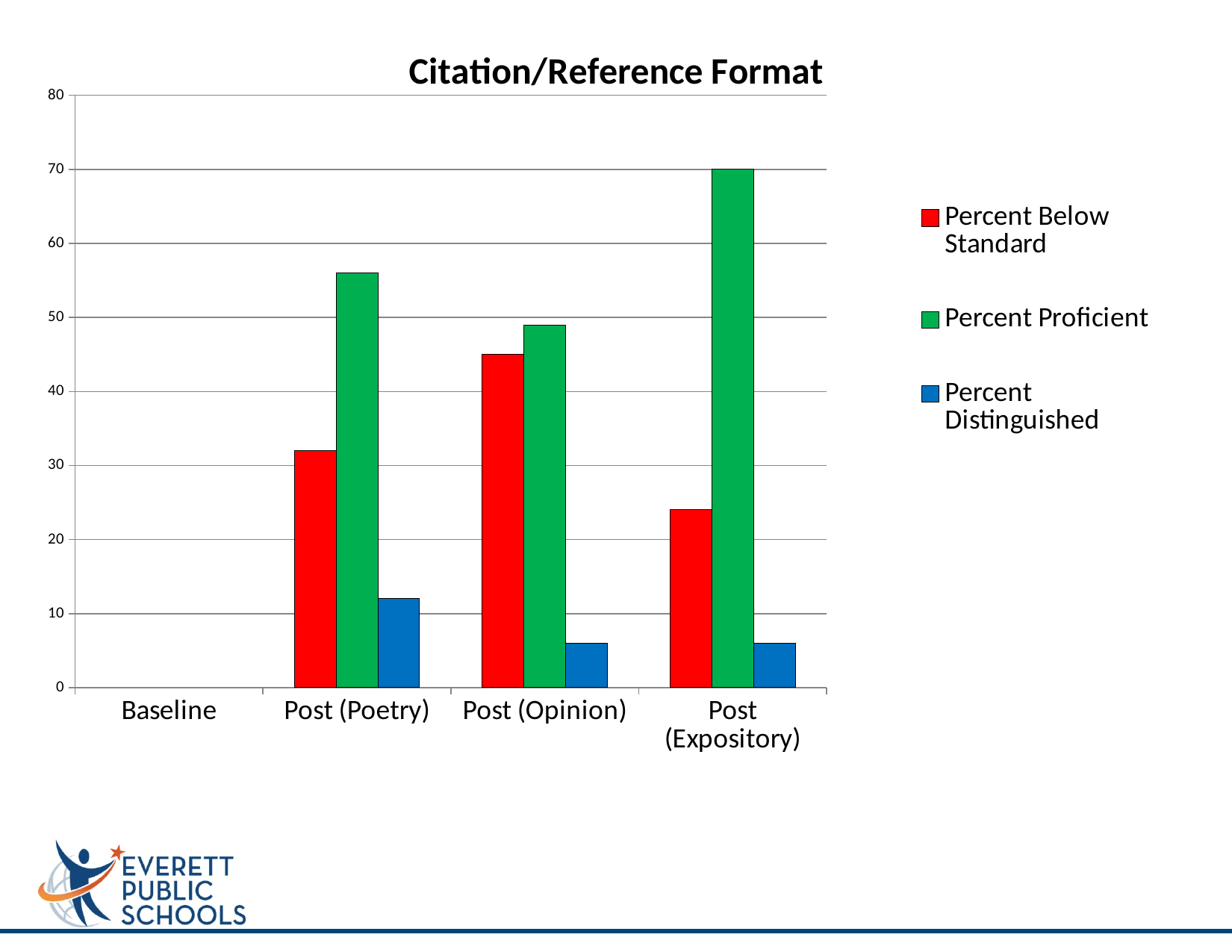
What kind of chart is shown on the slide? bar chart Is the Percent Distinguished value for Post (Opinion) greater or less than 10? less What is the title of the chart? Citation/Reference Format How many series does the legend list? 3 Which category has the highest Percent Distinguished value? Post (Poetry) Is the Percent Below Standard value for Post (Poetry) greater or less than 30? greater What is the Percent Proficient value for Post (Expository)? 70 Which category has the highest Percent Below Standard value? Post (Opinion) For Post (Poetry), which is larger: Percent Below Standard or Percent Proficient? Percent Proficient Which colour represents Percent Distinguished in the legend? blue How many categories are shown on the x axis? 4 Which category has the highest Percent Proficient value? Post (Expository)